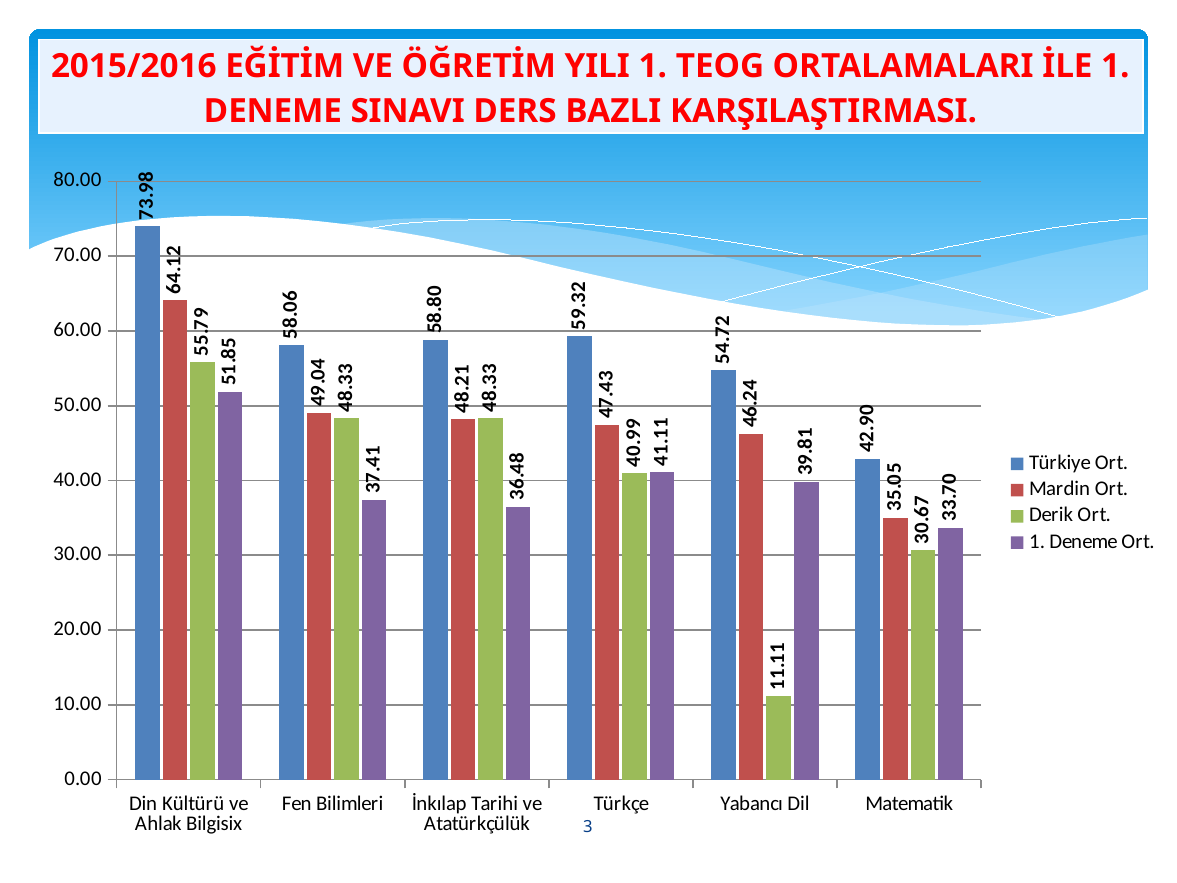
What is the 1. Deneme Ort. value for Matematik? 33.70 Which subject has the lowest Derik Ort. value? Yabancı Dil What is the Türkiye Ort. value for Din Kültürü ve Ahlak Bilgisi? 73.98 How many series does the legend list? 4 Which subject has the highest Türkiye Ort. value? Din Kültürü ve Ahlak Bilgisi What is the Derik Ort. value for Yabancı Dil? 11.11 How many subjects are shown on the x axis? 6 For Türkçe, what is the difference between the Türkiye Ort. and Mardin Ort. values? 11.89 For Fen Bilimleri, which is larger: Mardin Ort. or 1. Deneme Ort.? Mardin Ort. What kind of chart is shown on the slide? bar chart Is the Türkiye Ort. value for Yabancı Dil greater or less than 50.00? greater For Yabancı Dil, what is the difference between the Mardin Ort. and Derik Ort. values? 35.13